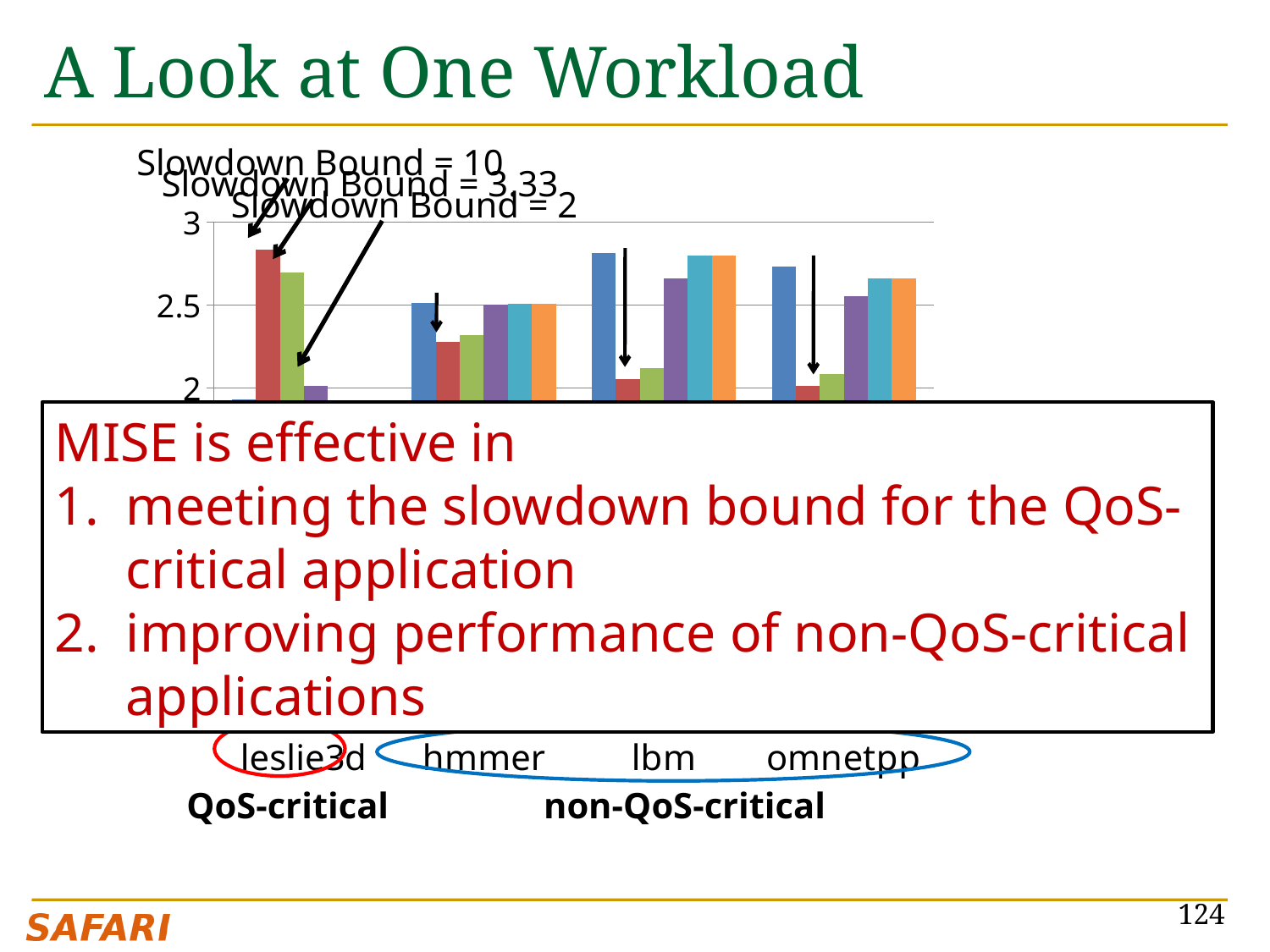
What kind of chart is shown on the slide? bar chart How many categories are labelled on the x axis of the chart? 4 Is the value of the red bar for omnetpp greater or less than 2.5? less Which categories on the x axis are grouped as non-QoS-critical? hmmer, lbm, omnetpp Which category on the x axis is labelled as QoS-critical? leslie3d Is the value of the red bar for leslie3d greater or less than 2.5? greater Is the value of the red bar for lbm greater or less than 2.5? less For leslie3d, which is larger: the red bar or the purple bar? the red bar For lbm, which is larger: the blue bar or the red bar? the blue bar